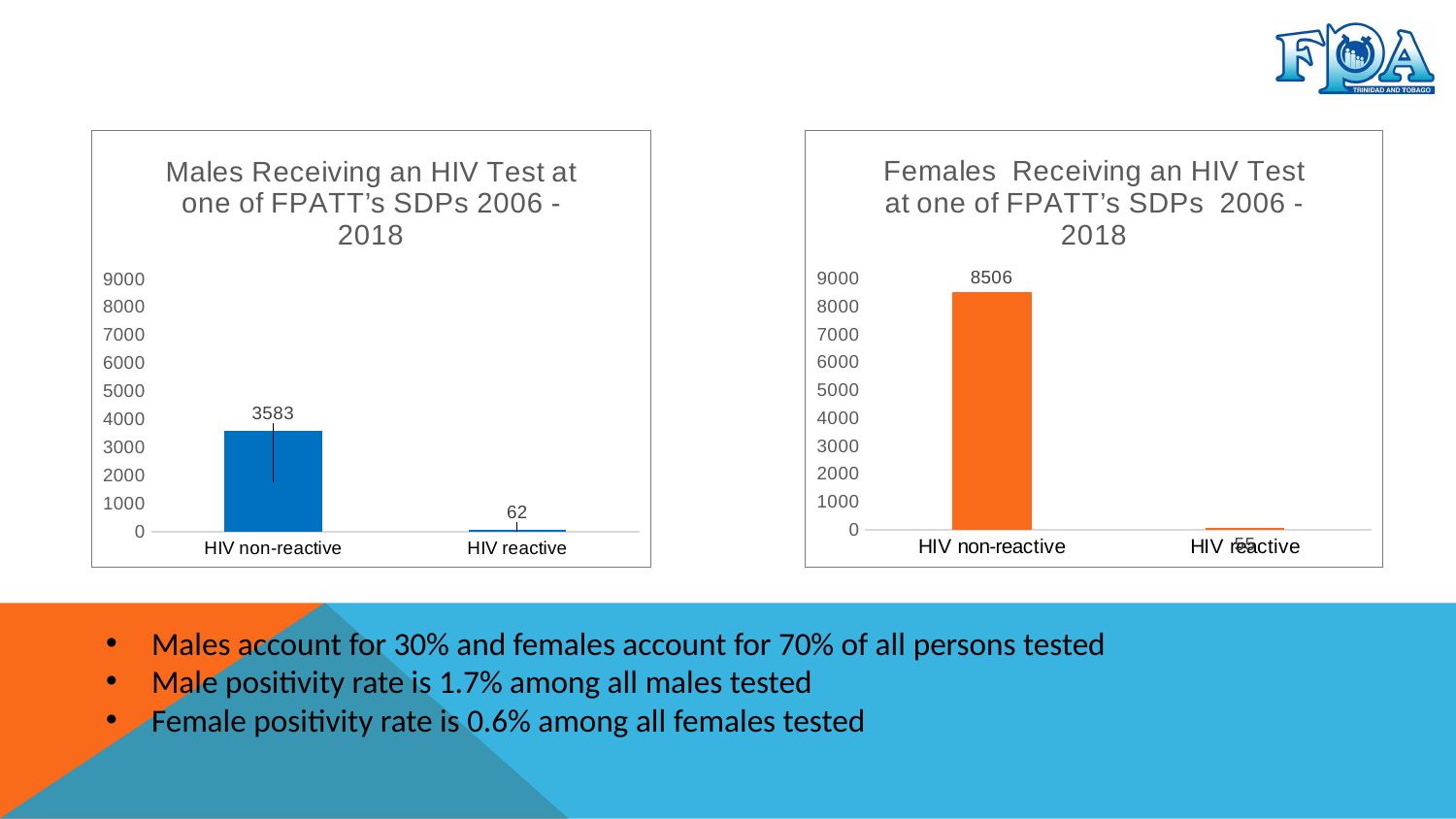
In the 'Males Receiving an HIV Test' chart, what is the value for HIV reactive? 62 How many categories are shown in the 'Males Receiving an HIV Test' chart? 2 What kind of chart is the 'Females Receiving an HIV Test' chart? bar chart In the 'Females Receiving an HIV Test' chart, is the value for HIV non-reactive greater or less than 8000? greater In the 'Females Receiving an HIV Test' chart, what is the value for HIV reactive? 55 Which is larger: HIV non-reactive in the Males chart or HIV non-reactive in the Females chart? HIV non-reactive in the Females chart In the 'Females Receiving an HIV Test' chart, what is the value for HIV non-reactive? 8506 In the 'Males Receiving an HIV Test' chart, which category has the highest value? HIV non-reactive In the 'Females Receiving an HIV Test' chart, which category has the lowest value? HIV reactive In the 'Males Receiving an HIV Test' chart, what is the difference between HIV non-reactive and HIV reactive? 3521 What colour are the bars in the 'Males Receiving an HIV Test' chart? blue In the 'Males Receiving an HIV Test' chart, what is the value for HIV non-reactive? 3583